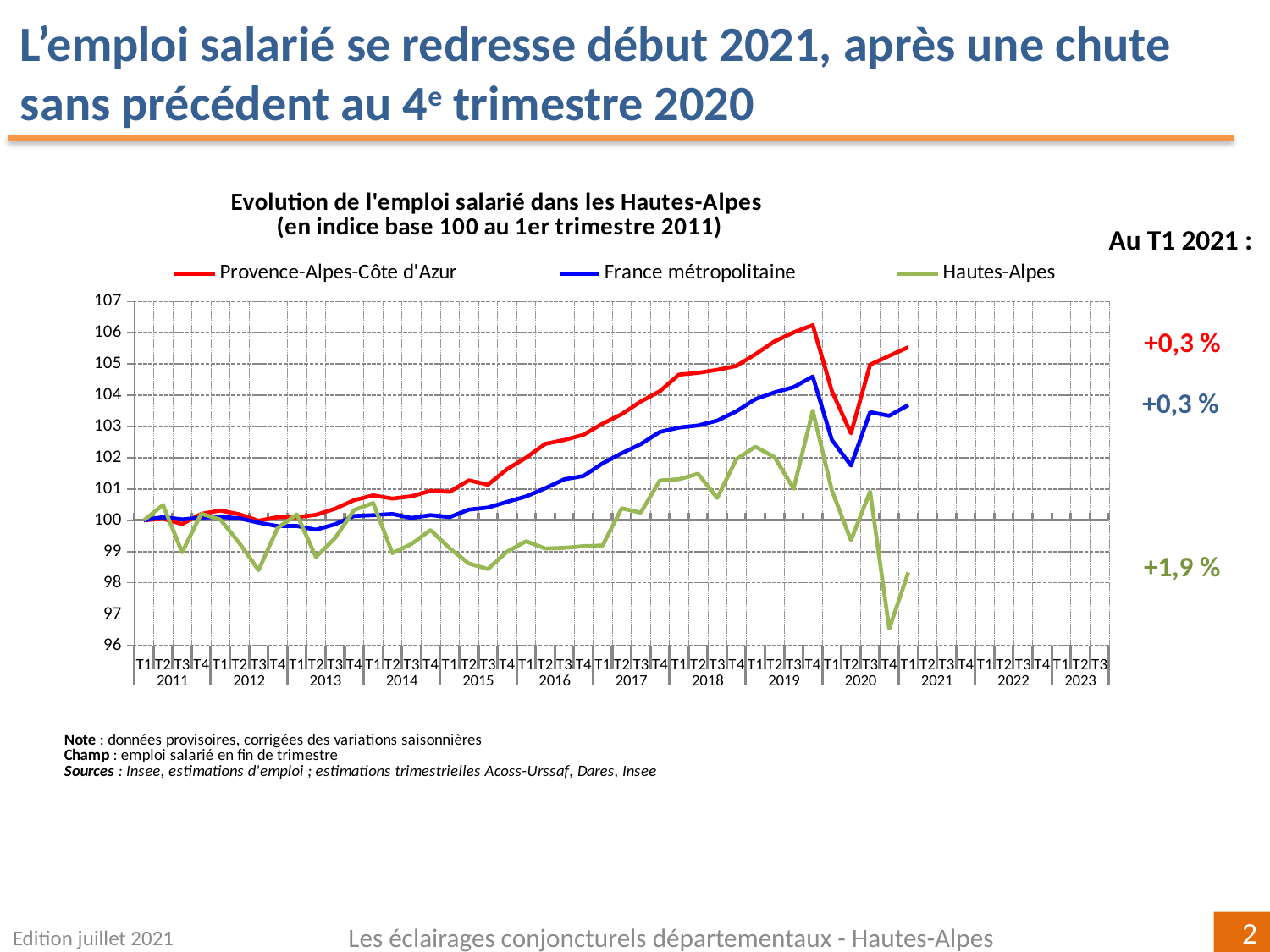
Which series reaches the highest index value on the chart? Provence-Alpes-Côte d'Azur According to the annotation at T1 2021, what is the change for Provence-Alpes-Côte d'Azur? +0,3 % Which series falls to the lowest index value on the chart? Hautes-Alpes What kind of chart is shown on the slide? line chart What colour is the Hautes-Alpes line? green What is the title of the chart? Evolution de l'emploi salarié dans les Hautes-Alpes (en indice base 100 au 1er trimestre 2011) Does the Provence-Alpes-Côte d'Azur line rise or fall between 2015 and 2019? rise Is the value for Hautes-Alpes at T4 2020 greater or less than 97? less Is the value for Provence-Alpes-Côte d'Azur at T4 2019 greater or less than 105? greater How many series does the legend list? 3 According to the annotation at T1 2021, what is the change for Hautes-Alpes? +1,9 % At T4 2019, which is higher: Provence-Alpes-Côte d'Azur or France métropolitaine? Provence-Alpes-Côte d'Azur